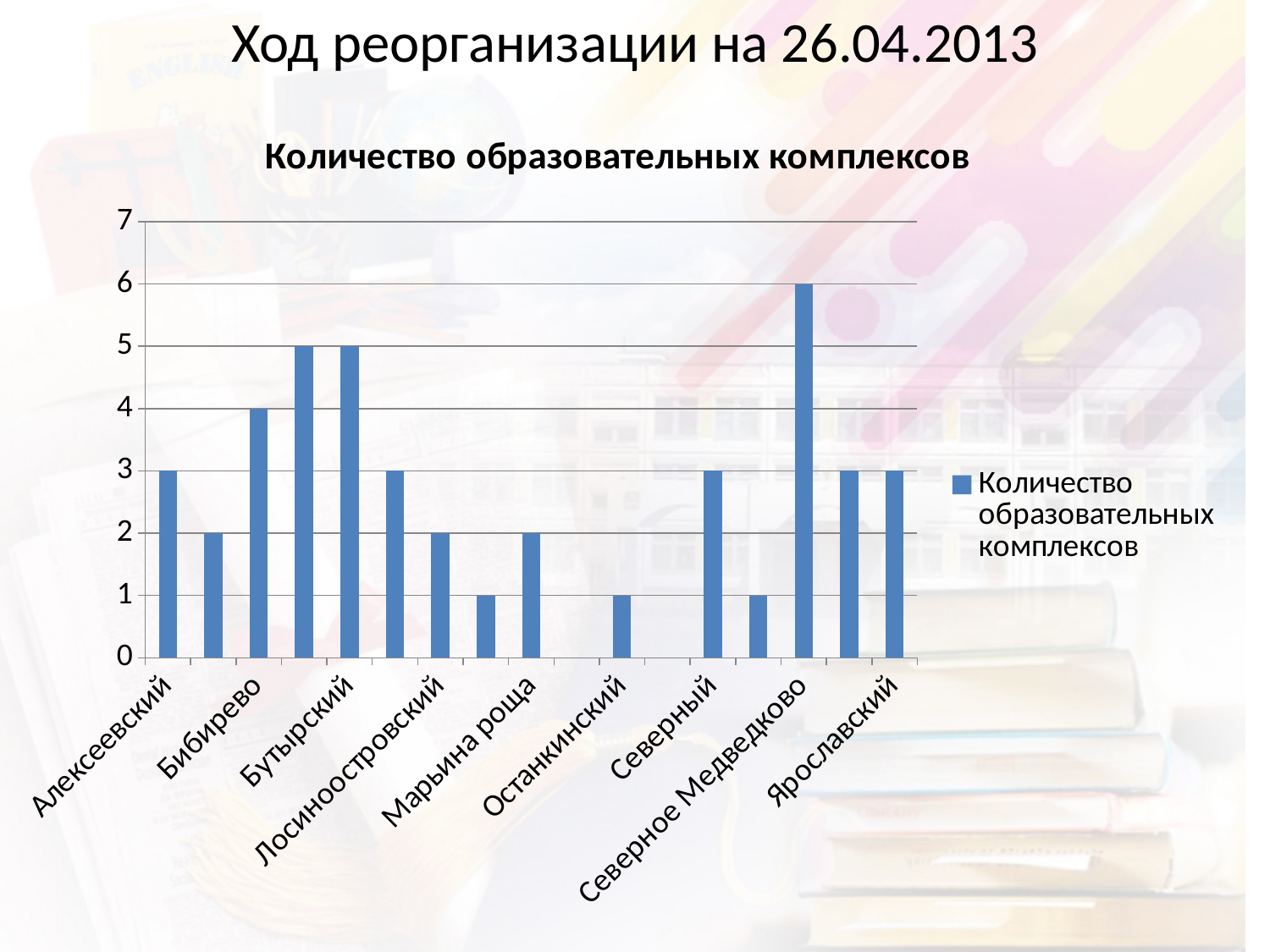
Which is larger, the value for Бутырский or the value for Лосиноостровский? Бутырский What is the value for Останкинский? 1 How many series does the legend list? 1 What is the difference between the values for Северное Медведково and Ярославский? 3 What is the value for Алексеевский? 3 Which category has the highest value? Северное Медведково What kind of chart is shown? bar chart What is the value for Бибирево? 4 Is the value for Северное Медведково greater or less than 5? greater What is the value for Бутырский? 5 What is the value for Северное Медведково? 6 How many bars are plotted in the chart? 15